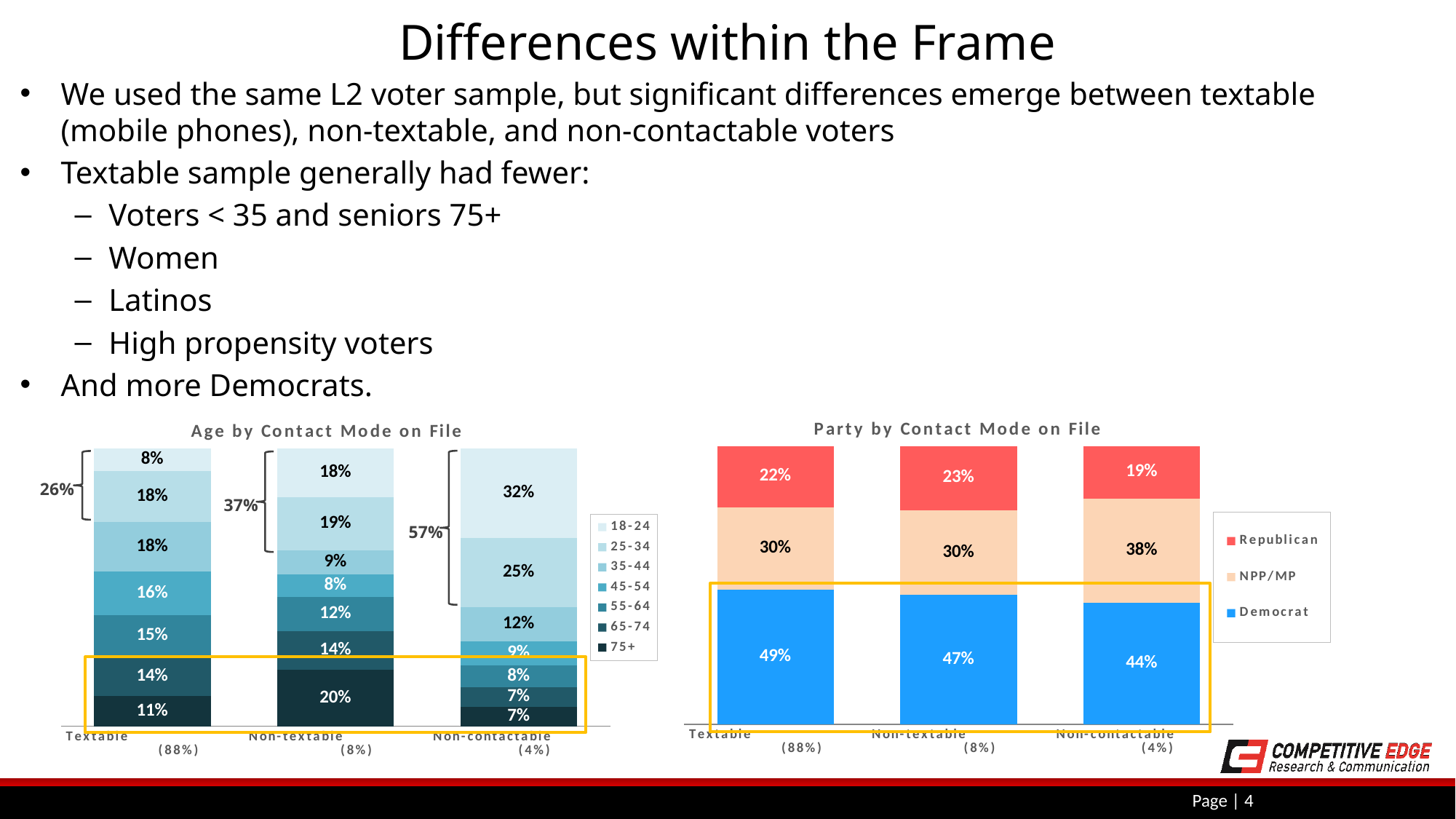
How many series does the legend of the 'Age by Contact Mode on File' chart list? 7 In the 'Party by Contact Mode on File' chart, which contact mode has the highest Democrat share? Textable In the 'Party by Contact Mode on File' chart, what is the Democrat share for Textable voters? 49% In the 'Age by Contact Mode on File' chart, is the 75+ share larger for Textable or Non-textable voters? Non-textable In the 'Party by Contact Mode on File' chart, what is the NPP/MP share for Non-contactable voters? 38% In the 'Age by Contact Mode on File' chart, what is the 75+ share for Non-textable voters? 20% In the 'Party by Contact Mode on File' chart, which contact mode has the lowest Republican share? Non-contactable In the 'Age by Contact Mode on File' chart, which contact mode has the lowest 18-24 share? Textable In the 'Party by Contact Mode on File' chart, what is the difference between the Democrat share for Textable and for Non-contactable voters? 5% What kind of chart is the 'Age by Contact Mode on File' chart? Stacked bar chart How many series does the legend of the 'Party by Contact Mode on File' chart list? 3 In the 'Age by Contact Mode on File' chart, what is the 18-24 share for Non-contactable voters? 32%